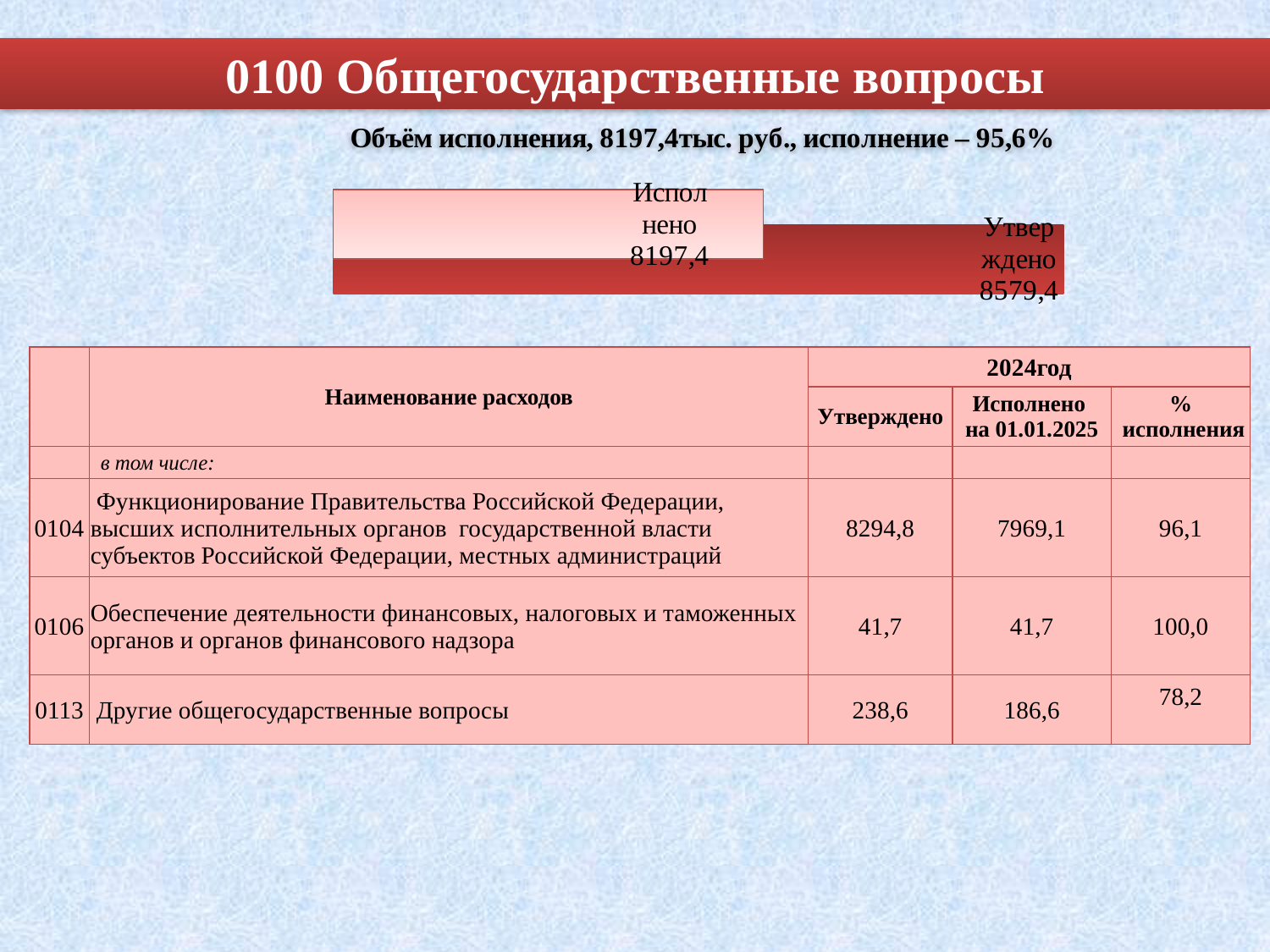
Are the bars in the chart horizontal or vertical? horizontal Which bar has the higher value, Исполнено or Утверждено? Утверждено Which bar is drawn in the darker red colour, Исполнено or Утверждено? Утверждено Which bar shows the highest value? Утверждено What is the value of the bar labelled Исполнено? 8197,4 What kind of chart is shown on the slide? bar chart What is the value of the bar labelled Утверждено? 8579,4 What is the difference between the Утверждено and Исполнено values? 382,0 How many bars are plotted in the chart? 2 Which bar shows the lowest value? Исполнено